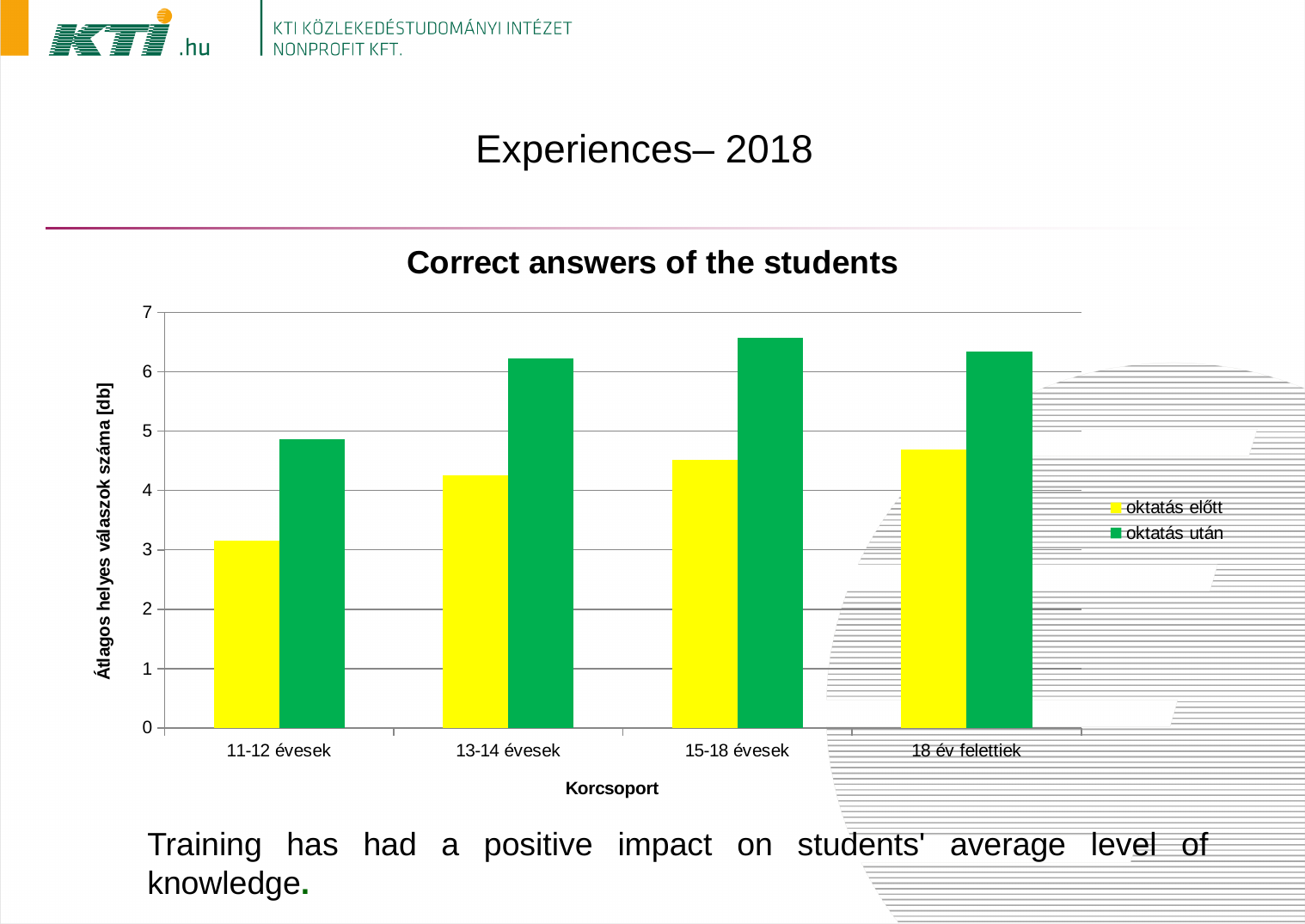
What is the label of the y axis of the chart? Átlagos helyes válaszok száma [db] Is the "oktatás előtt" value for 18 év felettiek greater or less than 4? greater Which is larger: the "oktatás után" value for 11-12 évesek or the "oktatás előtt" value for 13-14 évesek? oktatás után for 11-12 évesek Which age group has the lowest value for "oktatás előtt"? 11-12 évesek For 15-18 évesek, which is larger: the "oktatás előtt" value or the "oktatás után" value? oktatás után How many series does the legend of the chart list? 2 How many age groups (categories) are shown on the x axis of the chart? 4 What kind of chart is shown under the title "Correct answers of the students"? bar chart Is the "oktatás után" value for 13-14 évesek greater or less than 6? greater Is the "oktatás előtt" value for 11-12 évesek greater or less than 4? less Which age group has the highest value for "oktatás után"? 15-18 évesek Which age group has the lowest value for "oktatás után"? 11-12 évesek